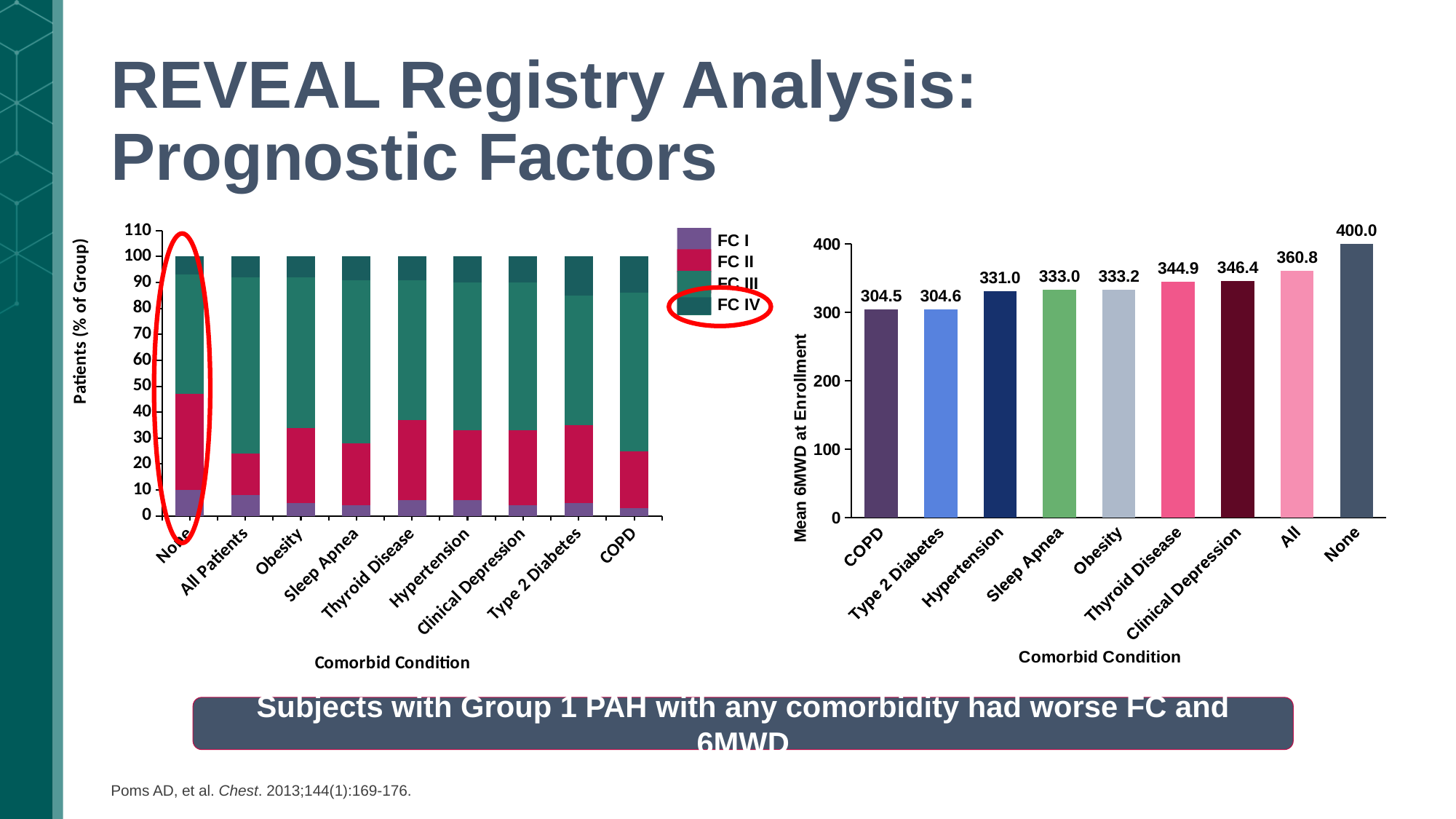
In the right chart (Mean 6MWD at Enrollment), what is the difference between the values for All and Hypertension? 29.8 In the right chart (Mean 6MWD at Enrollment), which comorbid condition has the highest mean 6MWD? None In the right chart (Mean 6MWD at Enrollment), what is the value for All? 360.8 What kind of chart is the right chart (Mean 6MWD at Enrollment)? bar chart In the right chart (Mean 6MWD at Enrollment), what is the value for None? 400.0 In the right chart (Mean 6MWD at Enrollment), what is the value for Thyroid Disease? 344.9 In the right chart (Mean 6MWD at Enrollment), which is larger, the value for Clinical Depression or the value for Sleep Apnea? Clinical Depression How many comorbid condition categories are shown in the left chart (Patients % of Group)? 9 How many series does the legend of the left chart (Patients % of Group) list? 4 In the right chart (Mean 6MWD at Enrollment), do the values rise or fall moving from COPD on the left to None on the right? rise In the left chart (Patients % of Group), is the top of the FC II segment for None greater or less than 40? greater In the right chart (Mean 6MWD at Enrollment), what is the difference between the values for None and COPD? 95.5